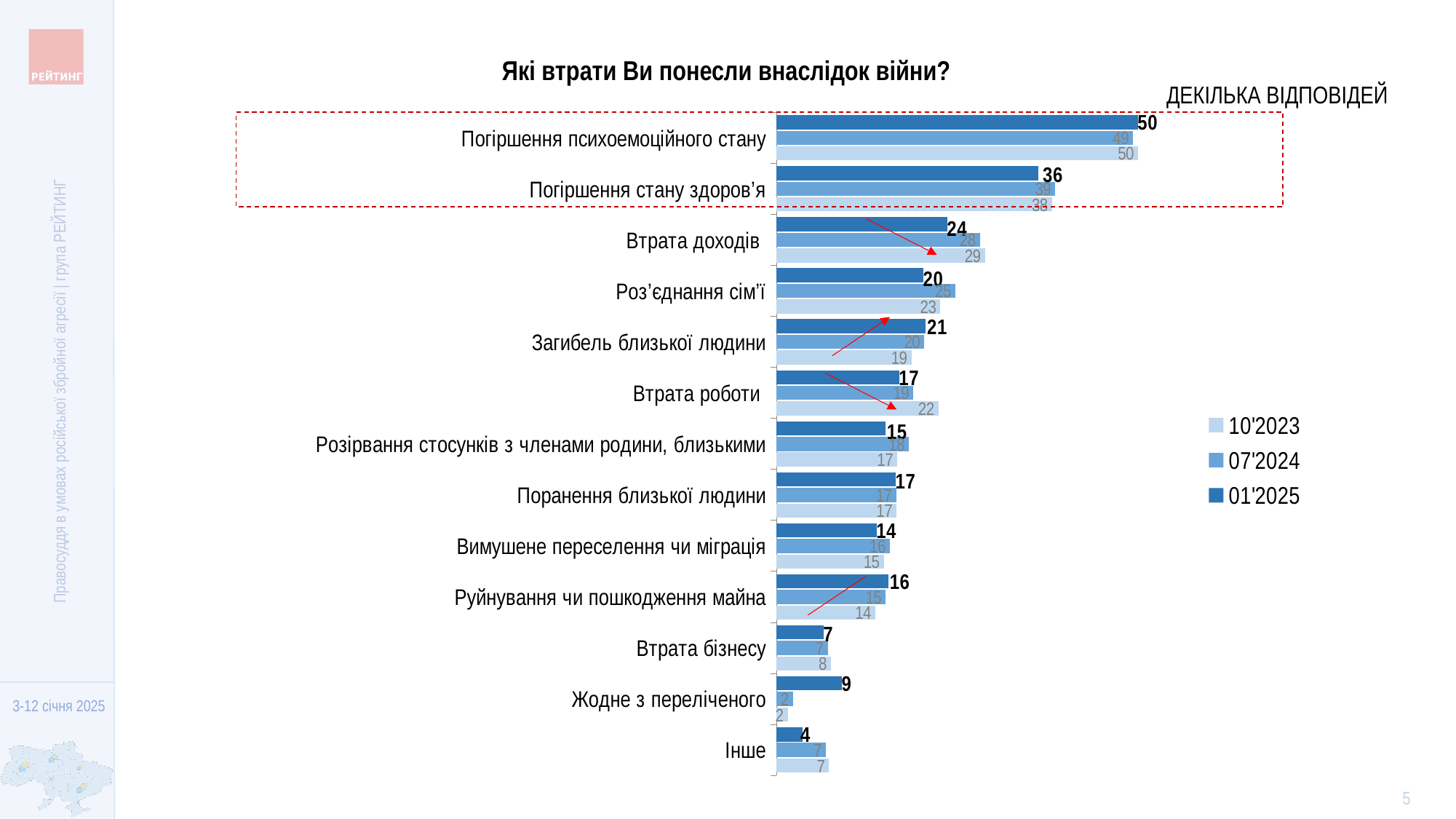
What kind of chart is shown on the slide? Bar chart What is the title of the chart? Які втрати Ви понесли внаслідок війни? What is the 10'2023 value for "Втрата роботи"? 22 How many categories are shown in the chart? 13 What is the 01'2025 value for "Погіршення психоемоційного стану"? 50 What is the 01'2025 value for "Руйнування чи пошкодження майна"? 16 Which category has the lowest 01'2025 value? Інше Which is larger for "Жодне з переліченого": the 01'2025 value or the 07'2024 value? 01'2025 Which category has the highest 01'2025 value? Погіршення психоемоційного стану What is the difference between the 10'2023 and 01'2025 values for "Втрата доходів"? 5 How many series does the legend list? 3 What is the 07'2024 value for "Погіршення стану здоров’я"? 39